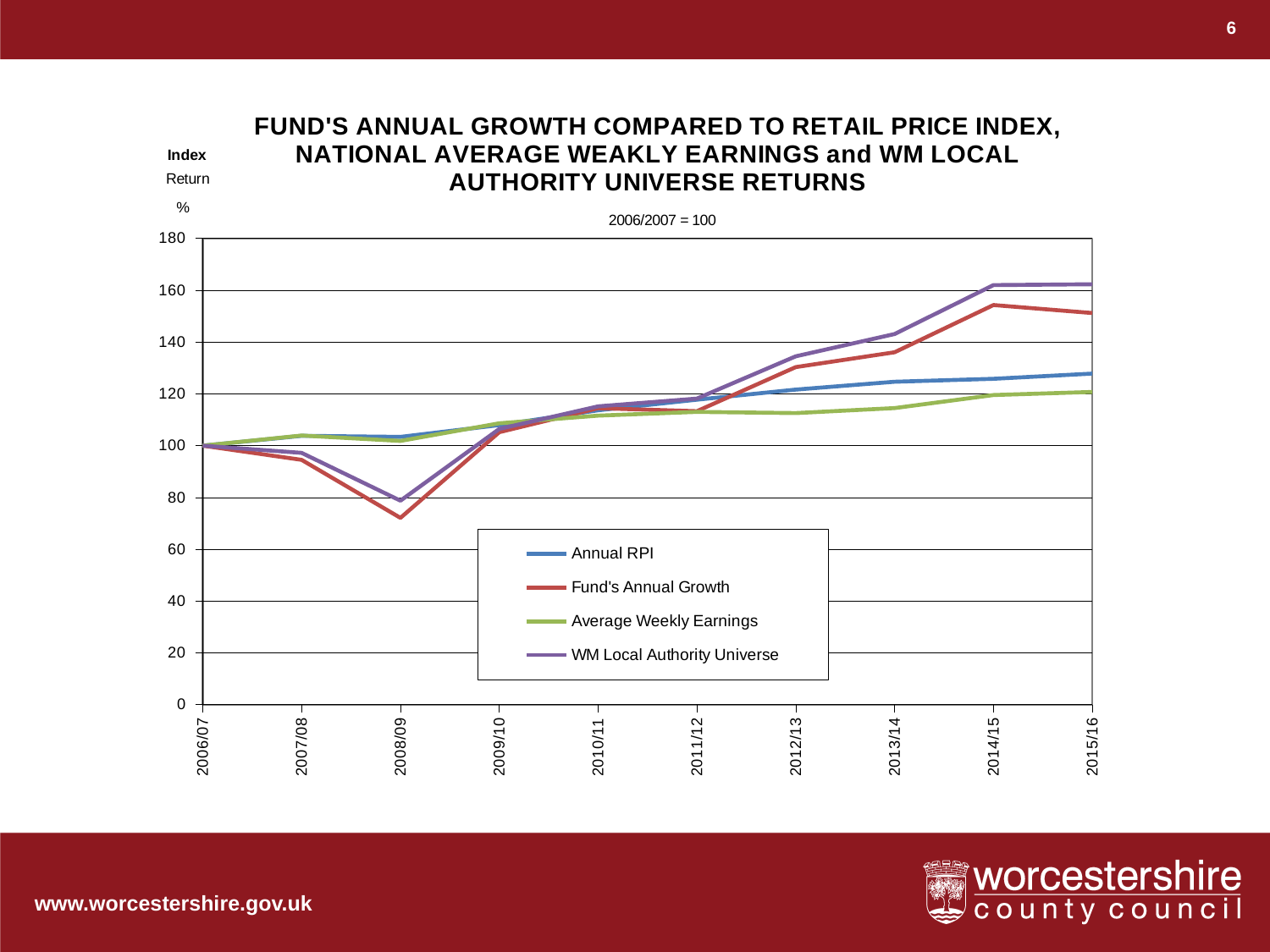
What kind of chart is shown on the slide? line chart Which series has the lowest value in 2008/09? Fund's Annual Growth Is the value for Fund's Annual Growth in 2014/15 greater or less than 160? less Which series has the lowest value in 2015/16? Average Weekly Earnings How many series does the legend list? 4 Which series has the highest value in 2015/16? WM Local Authority Universe Does the Annual RPI line rise or fall from 2006/07 to 2015/16? rise Is the value for Fund's Annual Growth in 2008/09 greater or less than 80? less In 2014/15, which is larger: Fund's Annual Growth or Annual RPI? Fund's Annual Growth How many years are plotted along the x axis? 10 What is the index value of all four series in 2006/07? 100